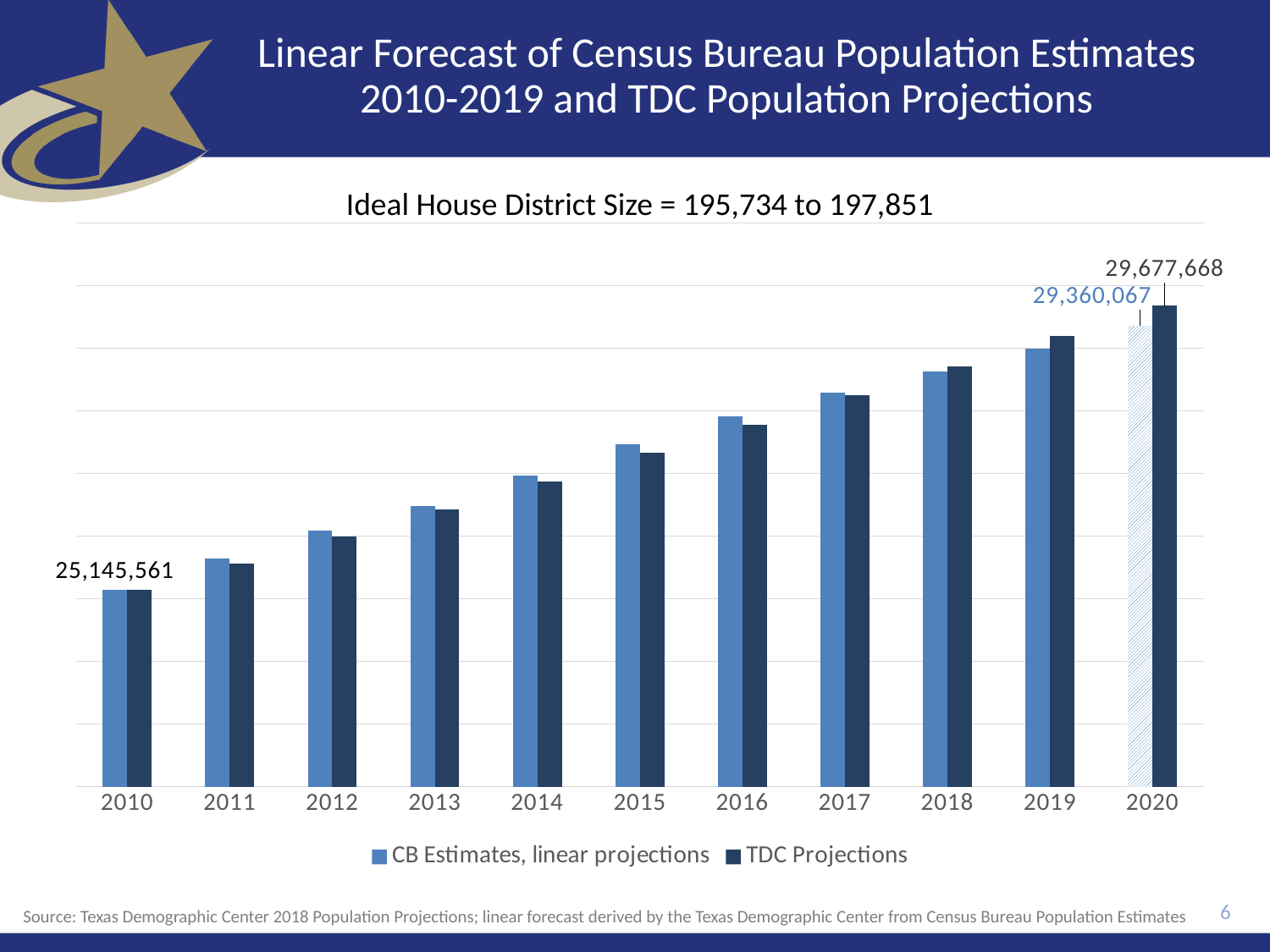
For 2020, which is larger: the TDC Projections value or the CB Estimates, linear projections value? TDC Projections For 2016, which is larger: the CB Estimates, linear projections value or the TDC Projections value? CB Estimates, linear projections How many years are shown on the x axis of the chart? 11 What type of chart is shown on the slide? bar chart What are the two series named in the chart legend? CB Estimates, linear projections; TDC Projections What is the TDC Projections value for 2020? 29,677,668 What is the CB Estimates, linear projections value for 2020? 29,360,067 Do the values rise or fall from 2010 to 2020? rise Which year has the lowest values in the chart? 2010 What is the difference between the TDC Projections value and the CB Estimates, linear projections value for 2020? 317,601 What value is labeled on the chart for 2010? 25,145,561 How many series does the chart legend list? 2